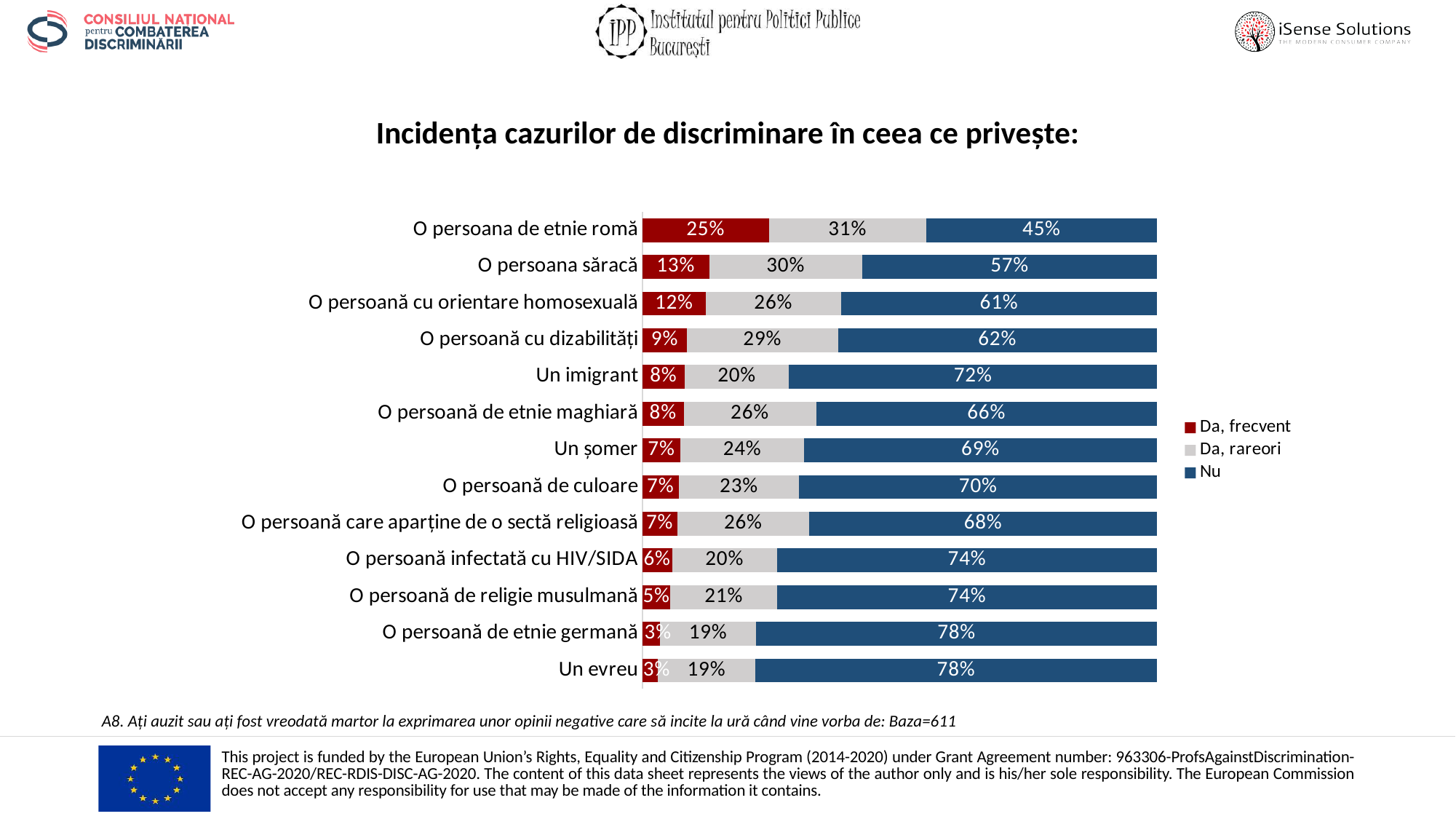
How many series does the legend list? 3 Which category has the lowest "Nu" value? O persoana de etnie romă What type of chart is shown on the slide? Stacked bar chart Which category has the highest "Da, frecvent" value? O persoana de etnie romă What is the total of the stacked bar for "O persoana săracă"? 100% Which series is shown in dark red in the legend? Da, frecvent What percentage answered "Da, frecvent" for "O persoana de etnie romă"? 25% How many categories are shown in the chart? 13 Which is larger: the "Da, rareori" value for "O persoana de etnie romă" or for "Un imigrant"? O persoana de etnie romă What is the "Nu" value for "Un imigrant"? 72% What is the "Da, rareori" value for "O persoană cu dizabilități"? 29% What is the difference between the "Nu" values for "Un imigrant" and "O persoană de etnie maghiară"? 6 percentage points